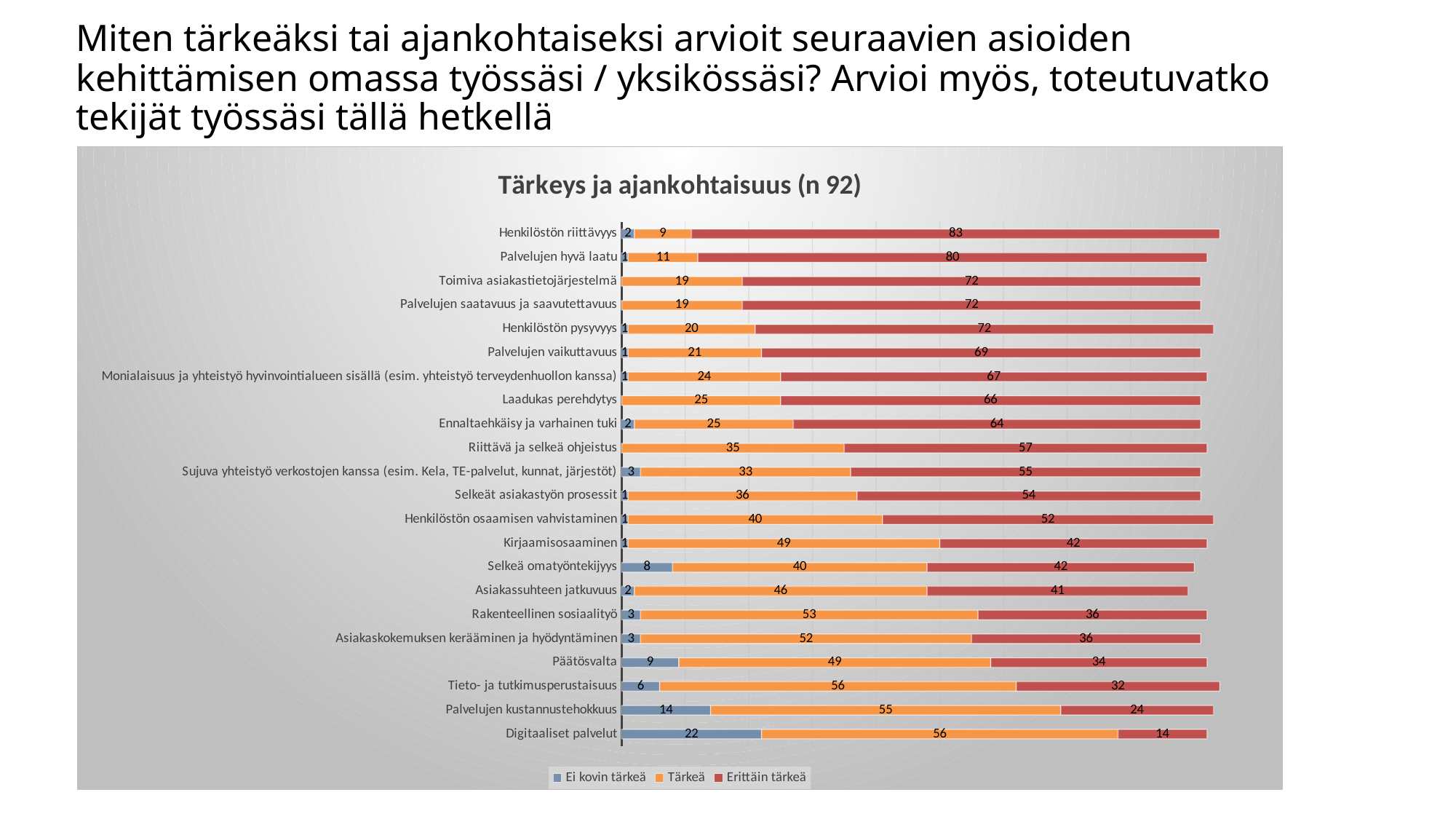
What is the total of the stacked bar for 'Digitaaliset palvelut'? 92 What is the 'Erittäin tärkeä' value for 'Henkilöstön riittävyys'? 83 How many categories are plotted in the chart? 22 Which category has the highest 'Ei kovin tärkeä' value? Digitaaliset palvelut What kind of chart is shown on the slide? Stacked bar chart What is the difference between the 'Erittäin tärkeä' values for 'Henkilöstön riittävyys' and 'Palvelujen hyvä laatu'? 3 How many series does the legend list? 3 Which has the larger 'Tärkeä' value, 'Kirjaamisosaaminen' or 'Selkeä omatyöntekijyys'? Kirjaamisosaaminen Which category has the highest 'Erittäin tärkeä' value? Henkilöstön riittävyys What is the 'Tärkeä' value for 'Digitaaliset palvelut'? 56 What is the 'Ei kovin tärkeä' value for 'Palvelujen kustannustehokkuus'? 14 Which category has the lowest 'Erittäin tärkeä' value? Digitaaliset palvelut